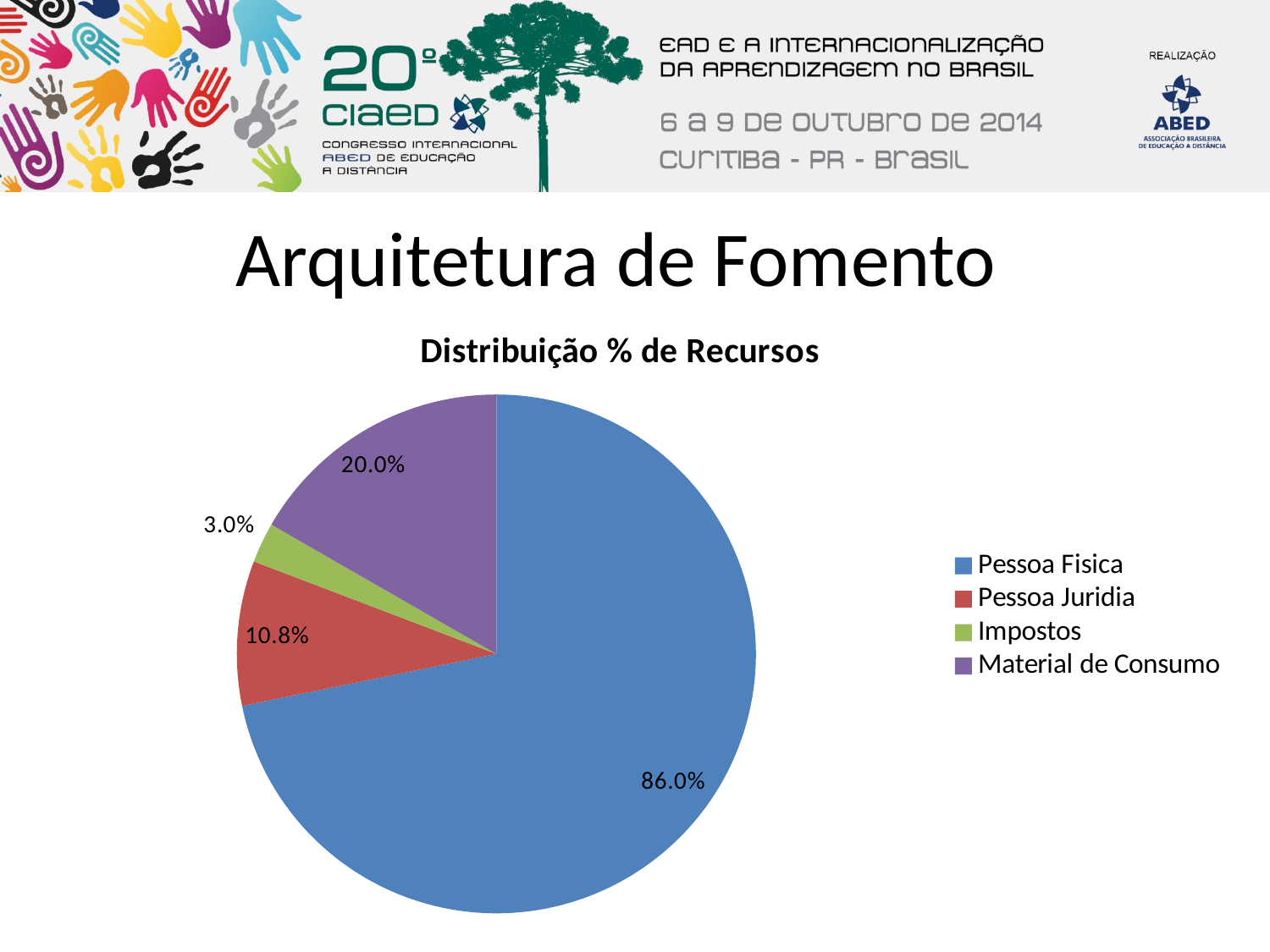
Which is larger, the Material de Consumo slice or the Pessoa Juridia slice? Material de Consumo Which category has the smallest slice of the pie? Impostos What value is labelled on the Material de Consumo slice? 20.0% How many categories does the legend list? 4 What colour is the Impostos slice? green Which category has the largest slice of the pie? Pessoa Fisica What value is labelled on the Impostos slice? 3.0% What value is labelled on the Pessoa Fisica slice? 86.0% What type of chart is shown on the slide? pie chart What is the difference between the labelled values for Pessoa Fisica and Material de Consumo? 66.0% What value is labelled on the Pessoa Juridia slice? 10.8% What is the title of the chart? Distribuição % de Recursos